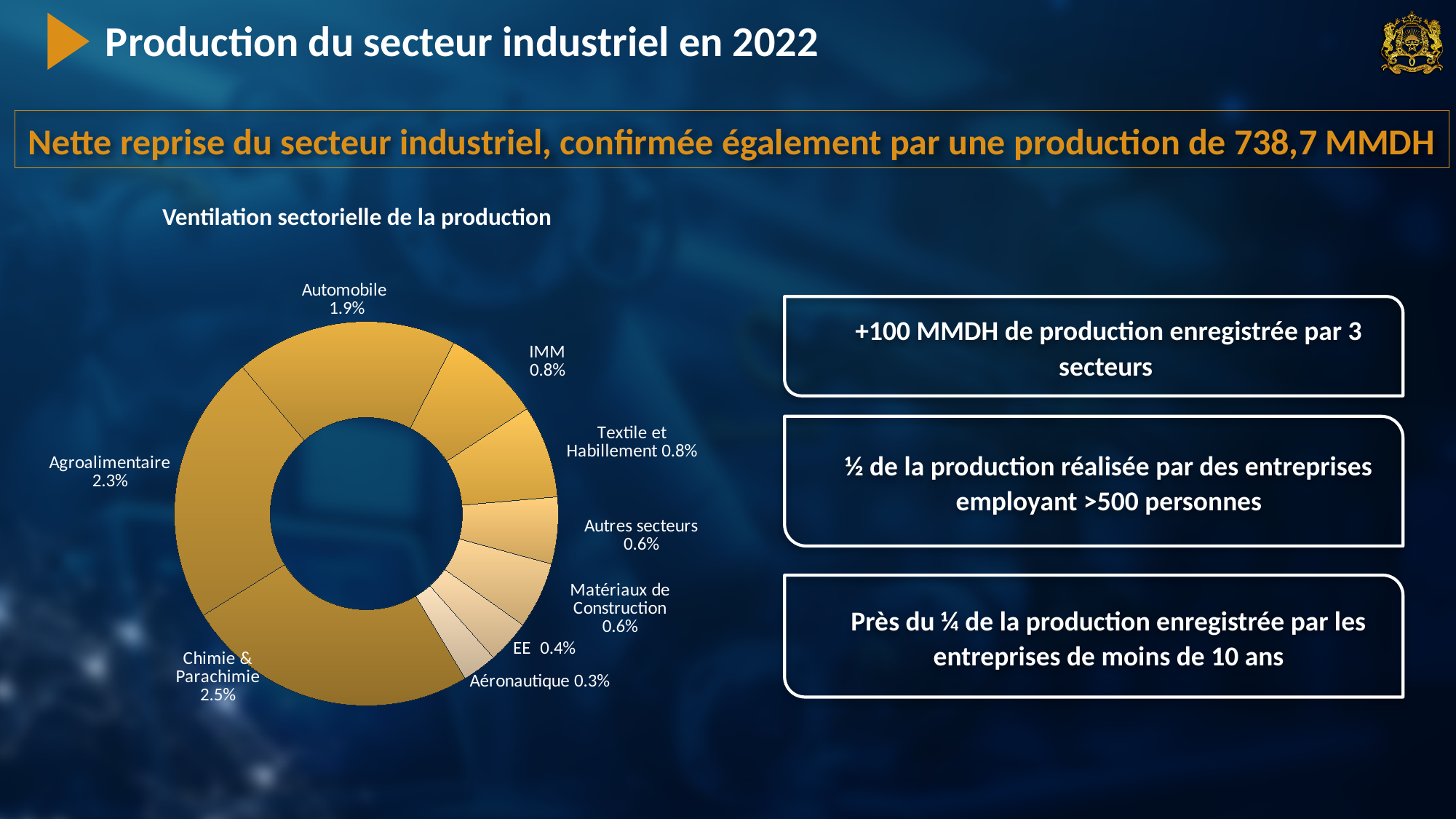
How many sectors are shown in the donut chart? 9 Which sector has the largest value in the donut chart? Chimie & Parachimie What is the difference between the values for Chimie & Parachimie and Automobile in the donut chart? 0.6% What is the value shown for Automobile in the donut chart? 1.9% Which has the larger value in the donut chart, Agroalimentaire or Automobile? Agroalimentaire Which sector has the smallest value in the donut chart? Aéronautique What is the value shown for Aéronautique in the donut chart? 0.3% What is the value shown for Matériaux de Construction in the donut chart? 0.6% What is the value shown for Agroalimentaire in the donut chart? 2.3% What is the value shown for Chimie & Parachimie in the donut chart? 2.5% What is the title of the donut chart? Ventilation sectorielle de la production What kind of chart is shown under the title 'Ventilation sectorielle de la production'? Donut (pie) chart